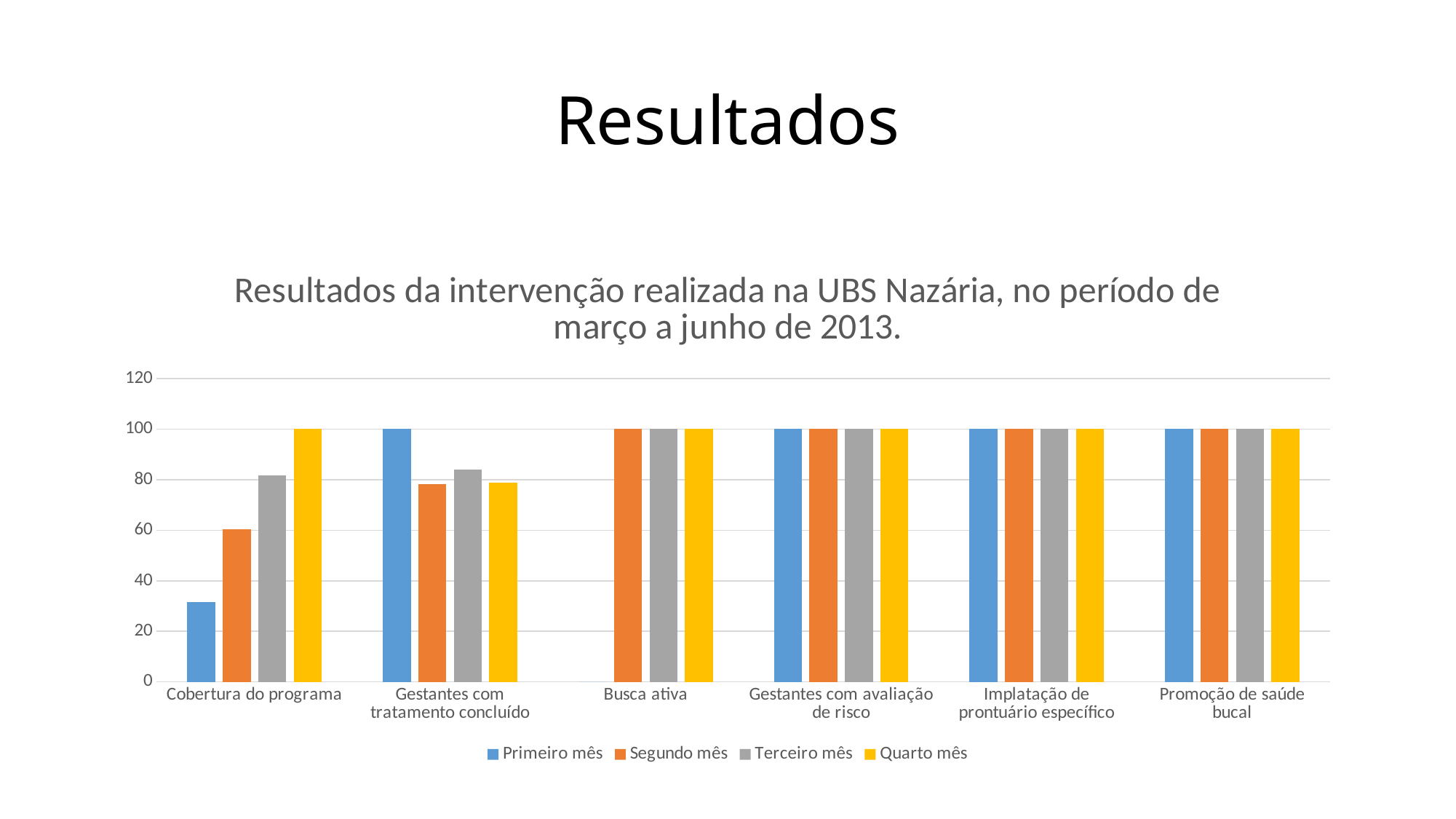
In the Cobertura do programa category, which is larger: Segundo mês or Terceiro mês? Terceiro mês In the Gestantes com tratamento concluído category, which series has the highest value? Primeiro mês What is the value for Quarto mês in the Cobertura do programa category? 100 What kind of chart is shown on the slide? bar chart In the Cobertura do programa category, which series has the lowest value? Primeiro mês How many series does the chart's legend list? 4 How many categories are shown on the x axis of the chart? 6 Is the value for Terceiro mês in Cobertura do programa greater or less than 60? greater Is the value for Segundo mês in Cobertura do programa greater or less than 80? less Do the values for Cobertura do programa rise or fall from Primeiro mês to Quarto mês? rise Is the value for Primeiro mês in Cobertura do programa greater or less than 40? less What is the value for Primeiro mês in the Gestantes com tratamento concluído category? 100